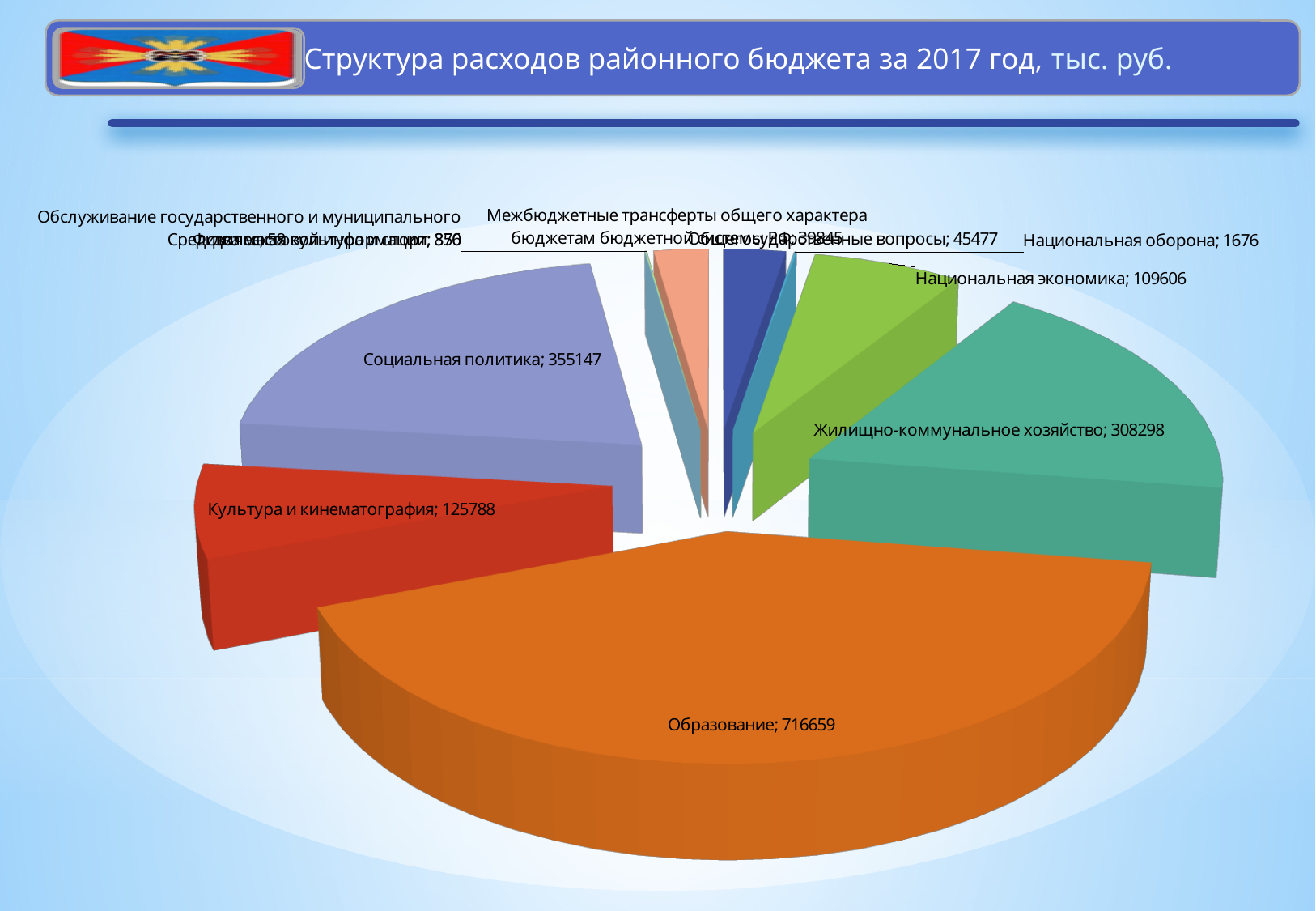
What is the value for Жилищно-коммунальное хозяйство? 308298 What kind of chart is shown on the slide? Pie chart What is the value for Общегосударственные вопросы? 45477 Which category has the largest slice of the pie? Образование Which is larger, Социальная политика or Жилищно-коммунальное хозяйство? Социальная политика What is the title of the slide? Структура расходов районного бюджета за 2017 год, тыс. руб. What is the value for Национальная экономика? 109606 What is the value for Национальная оборона? 1676 What is the value for Культура и кинематография? 125788 What is the difference between the values for Образование and Социальная политика? 361512 What is the value for Образование? 716659 What is the value for Социальная политика? 355147